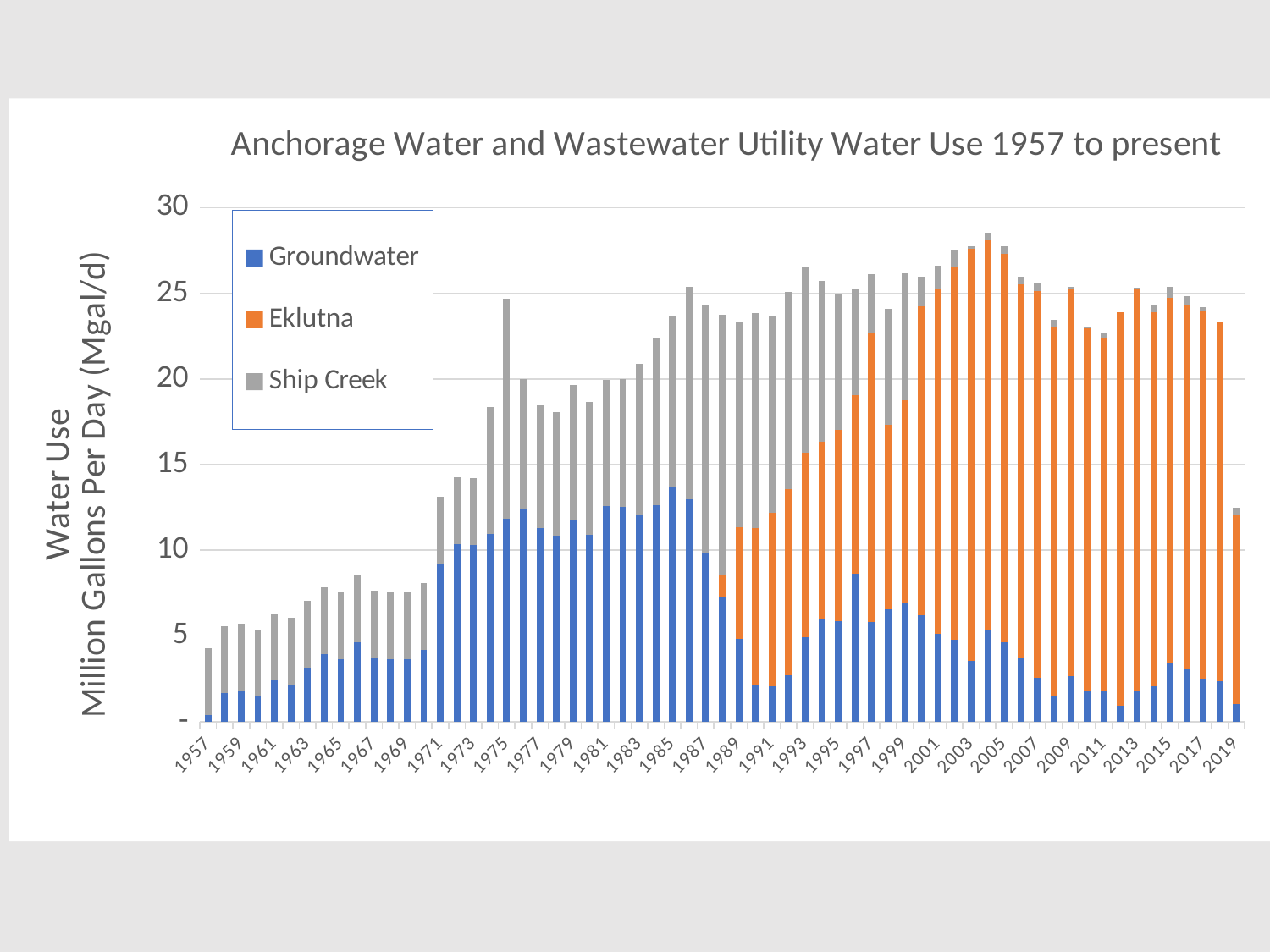
How many series does the legend list? 3 Is the total water use for 2019 greater or less than 15? less Do total water use values generally rise or fall from 1957 to 1985? rise Is the Groundwater value for 1985 greater or less than 10? greater What are the three series named in the legend? Groundwater, Eklutna, Ship Creek What kind of chart is shown on the slide? Stacked bar chart Is the total water use for 1957 greater or less than 5? less Which year has the highest total water use? 2004 Which year has the lowest total water use? 1957 Which year has the larger total water use, 1957 or 2005? 2005 What is the title of the chart? Anchorage Water and Wastewater Utility Water Use 1957 to present